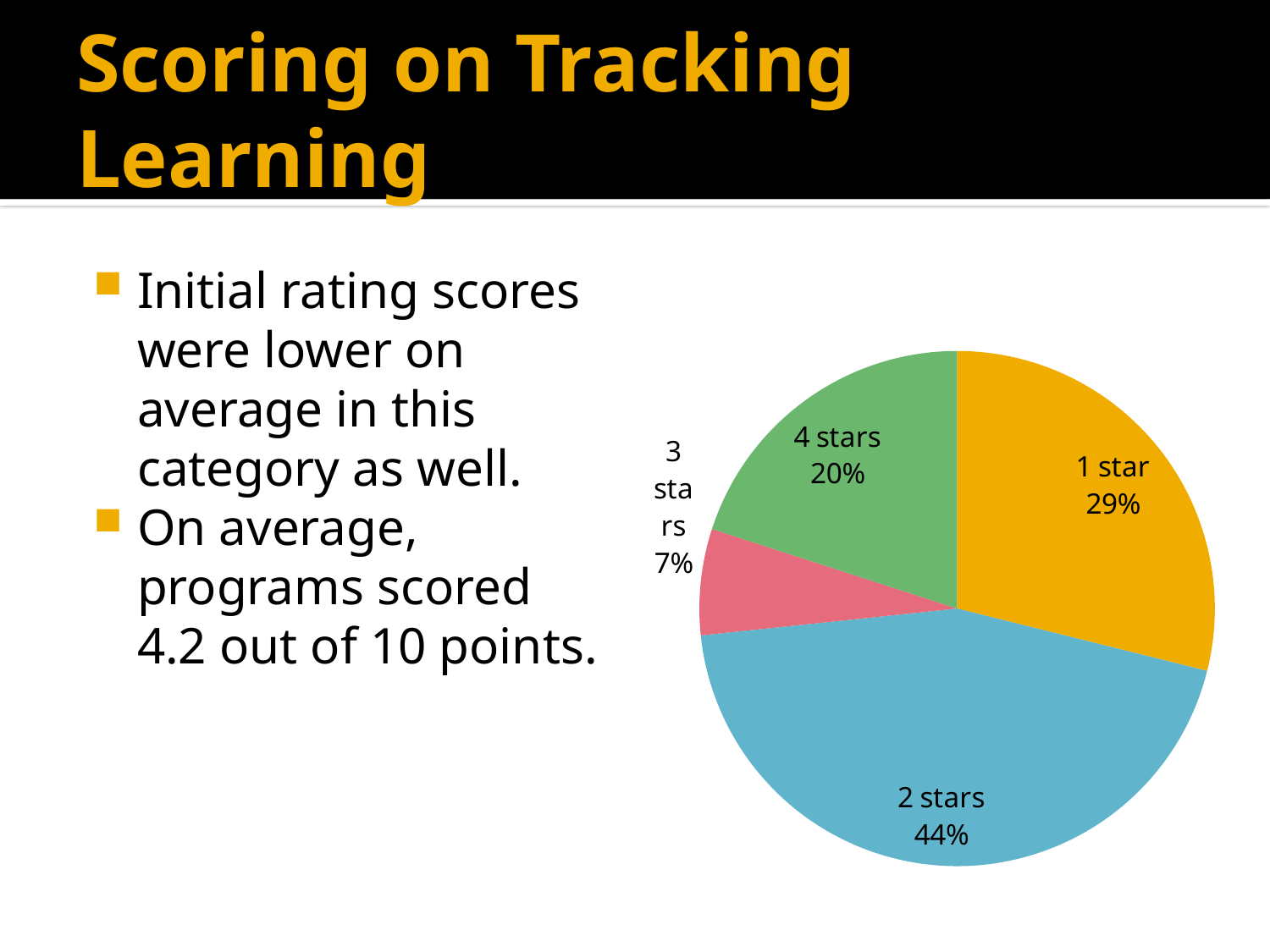
What percentage of programs received 3 stars? 7% Which rating category has the smallest share of the pie? 3 stars How many slices does the pie chart have? 4 What is the difference in percentage points between the 2 stars slice and the 1 star slice? 15 Which rating category has the largest share of the pie? 2 stars What is the combined share of the 1 star and 2 stars slices? 73% What percentage of programs received 1 star? 29% What percentage of programs received 2 stars? 44% Which slice is larger, 4 stars or 3 stars? 4 stars What kind of chart is shown on the slide? pie chart What colour is the 2 stars slice? blue What percentage of programs received 4 stars? 20%